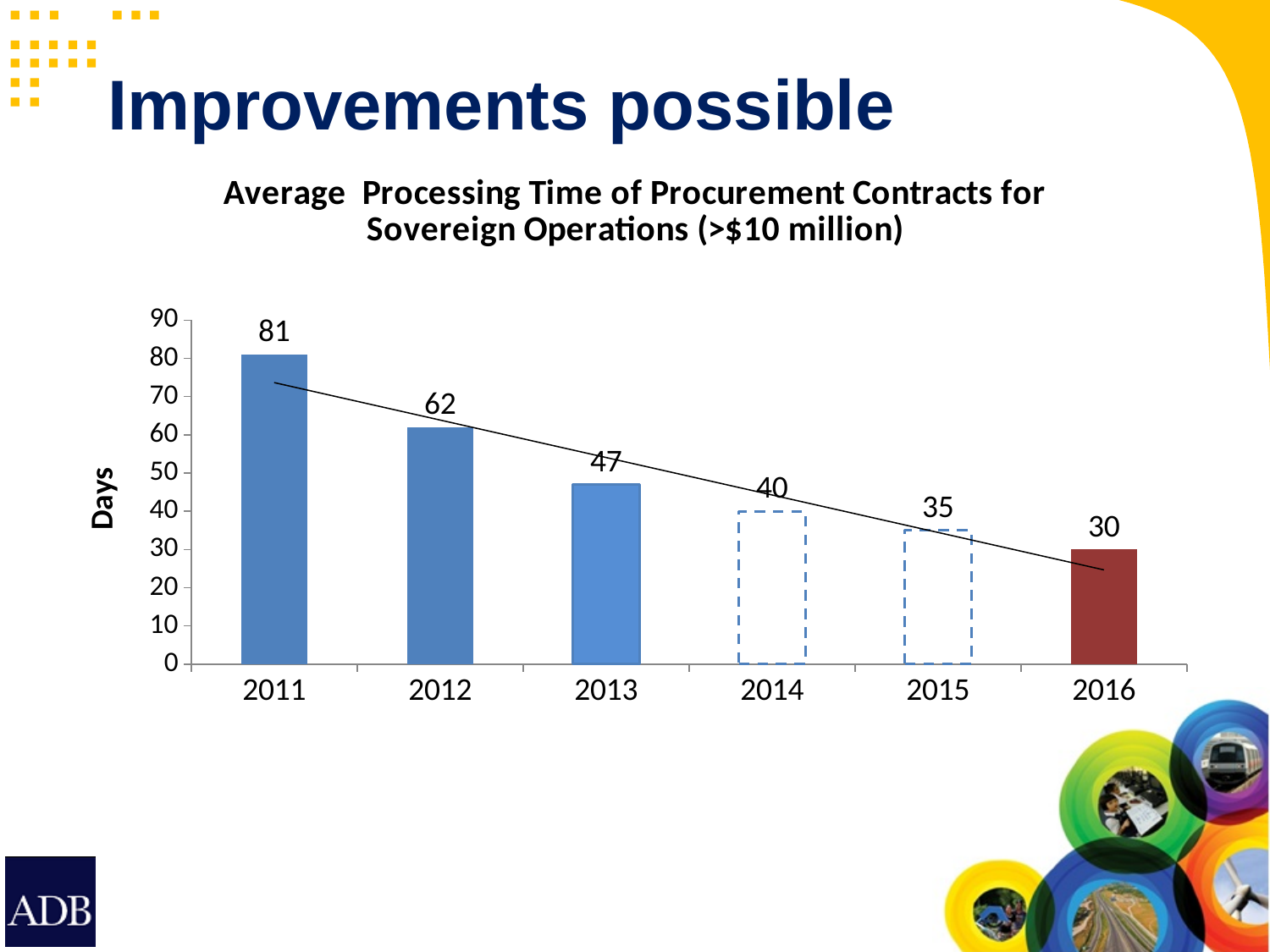
What is the value shown for 2013? 47 How many years are shown on the x axis? 6 What is the difference in days between 2011 and 2012? 19 What is the average processing time in days for 2011? 81 Which year has the lowest average processing time? 2016 What is the value shown for 2016? 30 Which is larger, the value for 2013 or the value for 2015? 2013 Do the values rise or fall from 2011 to 2016? fall Is the value for 2012 greater or less than 60? greater What kind of chart is this? bar chart Which year has the highest average processing time? 2011 What is the difference in days between 2014 and 2016? 10